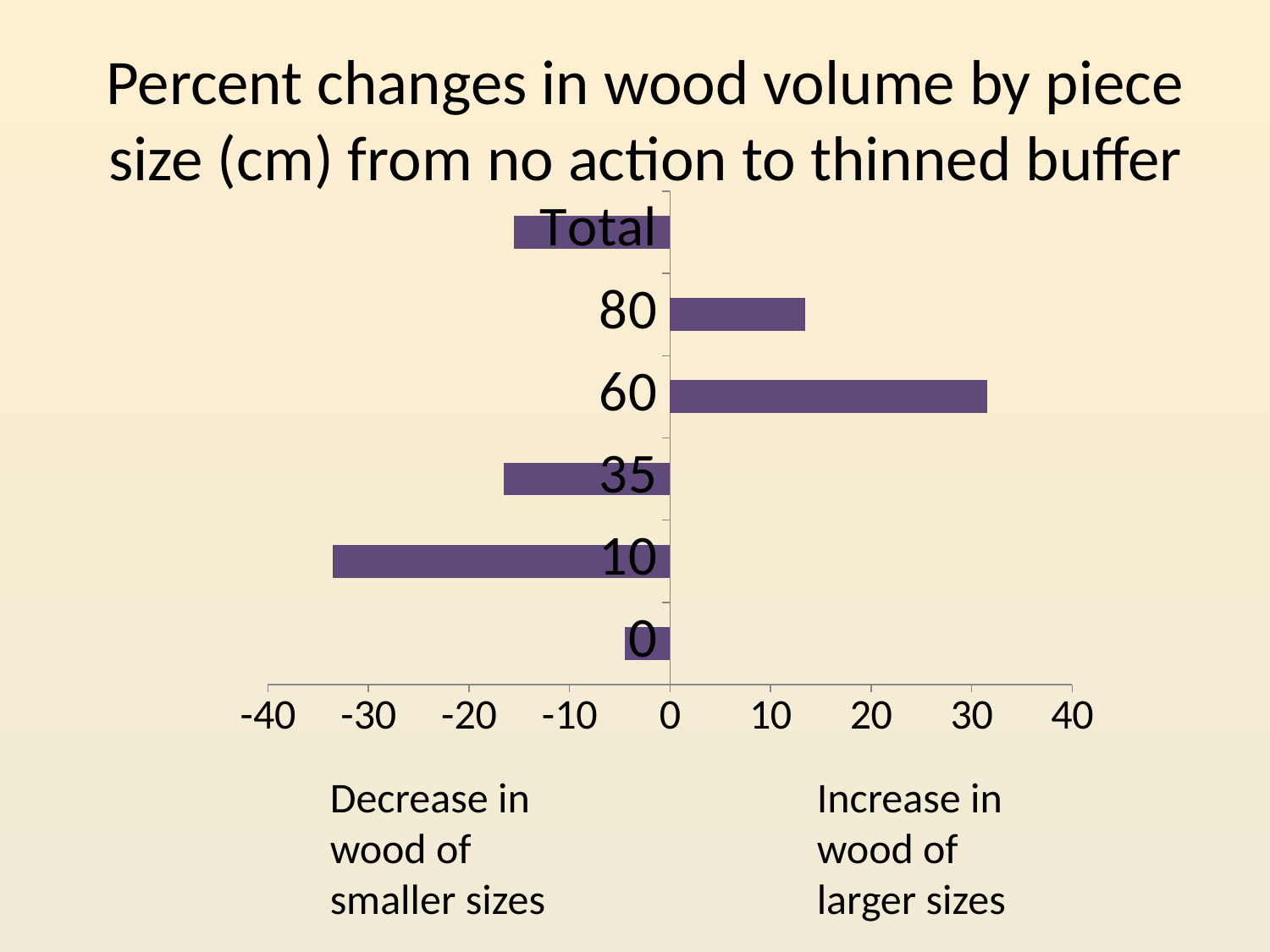
Which category has the lowest value? 10 Is the value for the 80 cm category greater or less than 10? greater Is the value for the 10 cm category greater or less than -30? less How many categories are plotted on the chart? 6 Which category has the highest value? 60 Which has the larger value, the 60 cm category or the 80 cm category? 60 What is the title of the chart? Percent changes in wood volume by piece size (cm) from no action to thinned buffer How many categories show a positive (increase) value? 2 Is the value for the 60 cm category greater or less than 20? greater What kind of chart is shown on the slide? bar chart